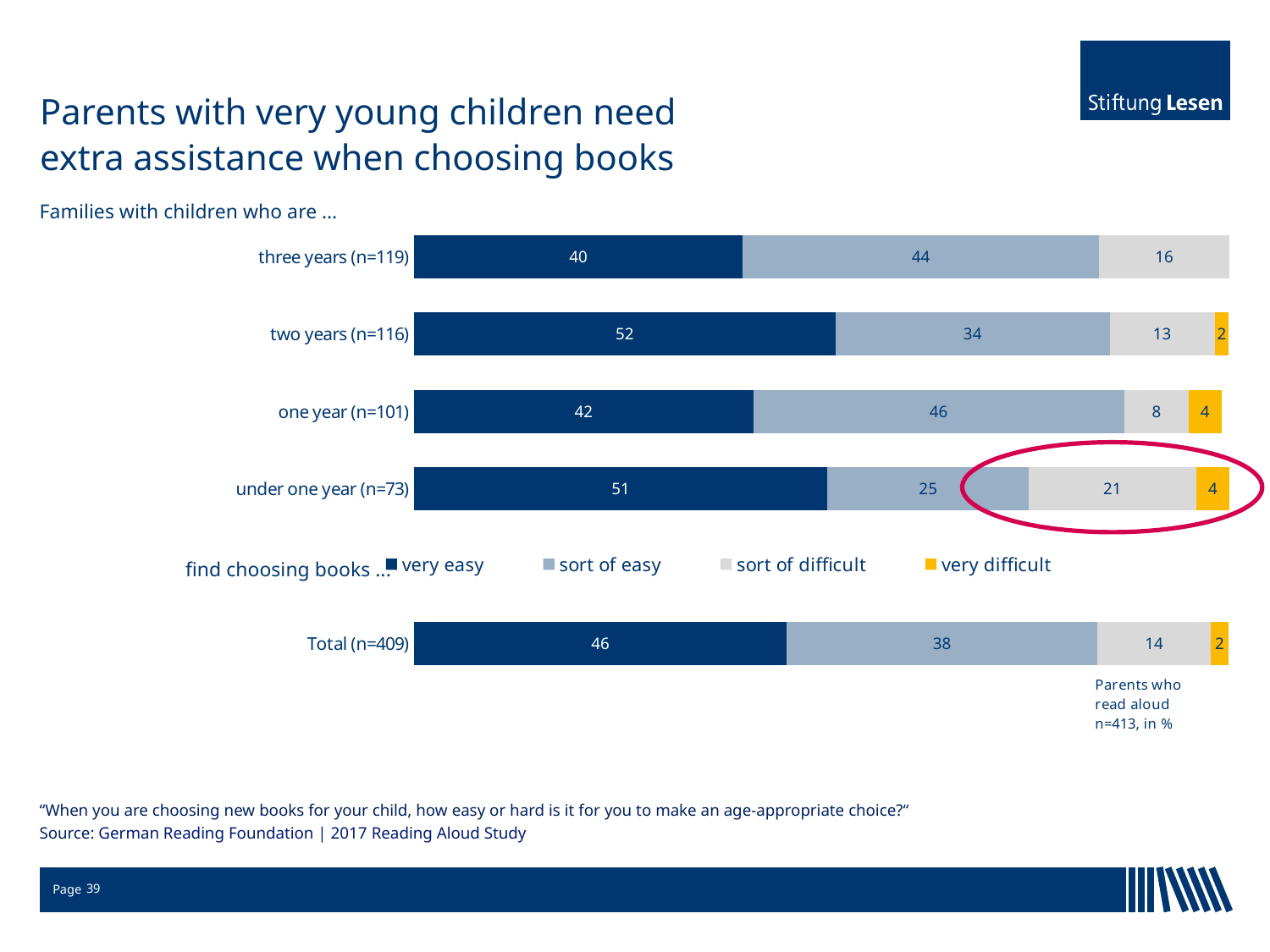
Which is larger: the 'very easy' value for one year or for under one year? under one year Which age group has the highest 'very easy' value? two years (n=116) What is the 'very difficult' value for families with one-year-old children? 4 What is the 'sort of difficult' value for families with children under one year? 21 How many series does the legend list? 4 Which age group has the lowest 'sort of easy' value? under one year (n=73) Which legend entry is shown in yellow? very difficult What is the sum of the 'very easy' and 'sort of easy' values for the two years (n=116) bar? 86 What percentage of parents with three-year-old children find choosing books very easy? 40 What is the difference between the 'sort of difficult' values for under one year and one year? 13 What kind of chart is shown on the slide? stacked bar chart What is the 'sort of easy' value for the Total (n=409) bar? 38